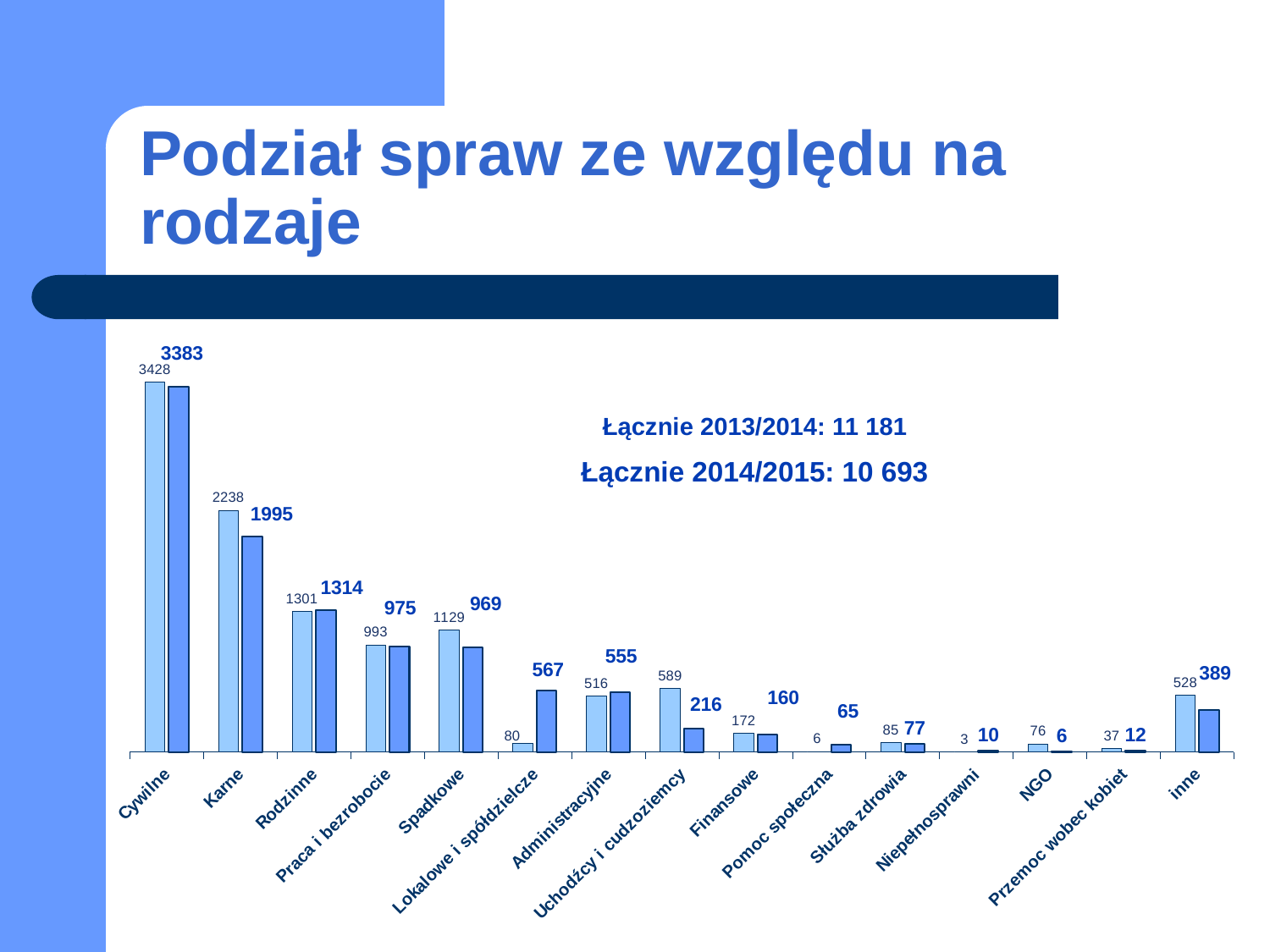
How many categories are shown on the x axis? 15 What is the value of the dark blue bar for Karne? 1995 What is the difference between the light blue and dark blue bars for Karne? 243 Which category has the lowest light blue bar? Niepełnosprawni What is the title of the slide? Podział spraw ze względu na rodzaje What is the value of the light blue bar for Pomoc społeczna? 6 For Spadkowe, which bar is larger, the light blue or the dark blue? light blue Which category has the highest light blue bar? Cywilne What is the value of the light blue bar for Cywilne? 3428 What is the value of the dark blue bar for Lokalowe i spółdzielcze? 567 What is the difference between the dark blue and light blue bars for Lokalowe i spółdzielcze? 487 What kind of chart is shown on the slide? bar chart